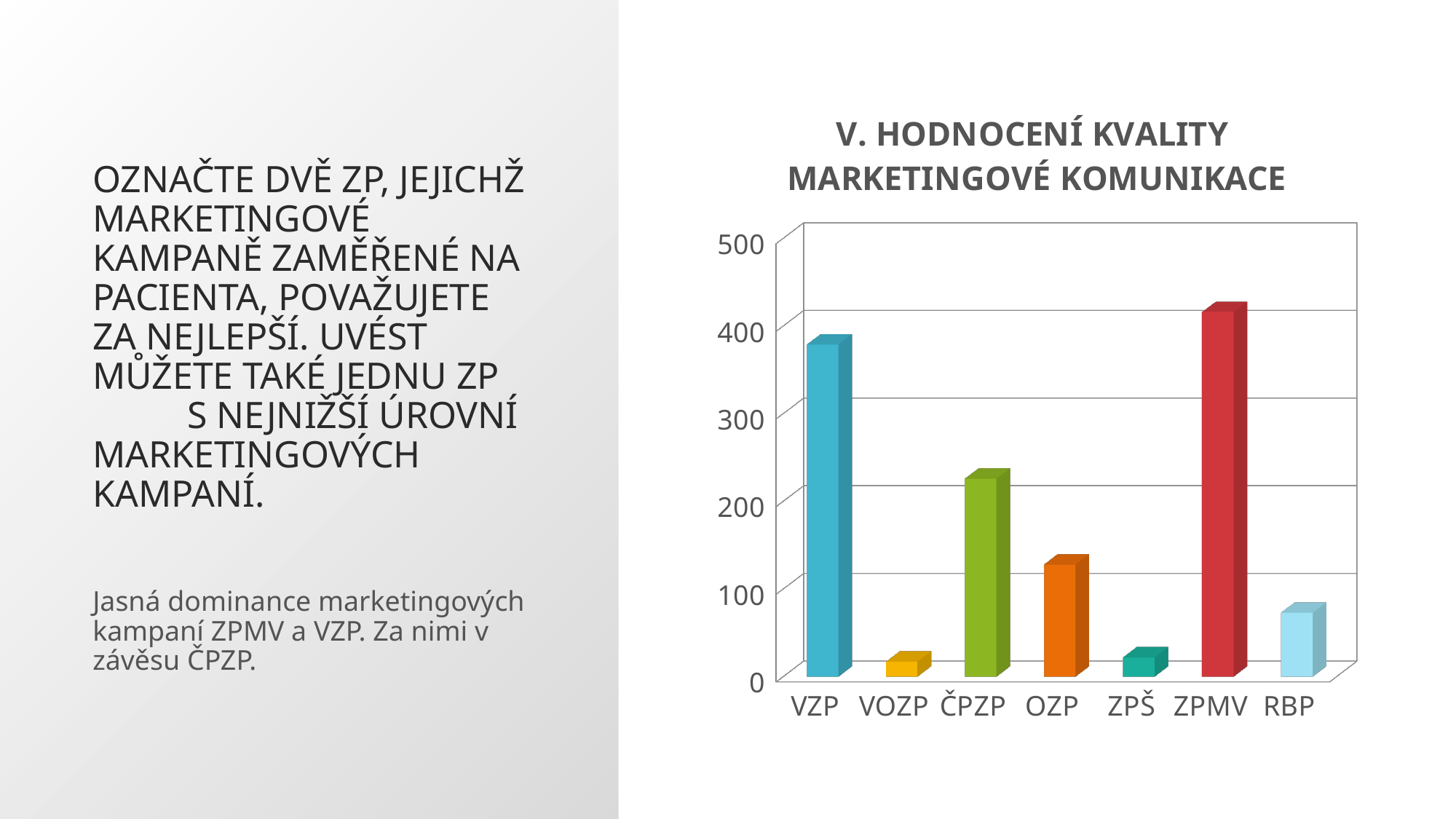
Which category has the highest bar in the chart? ZPMV Is the value for OZP greater or less than 100? greater What kind of chart is shown on the slide? bar chart Which is larger, the value for VZP or the value for ZPMV? ZPMV Which is larger, the value for ČPZP or the value for OZP? ČPZP Is the value for VZP greater or less than 300? greater What colour is the bar for ZPMV? red Is the value for RBP greater or less than 100? less How many categories are shown on the x axis of the chart? 7 What is the title of the chart? V. HODNOCENÍ KVALITY MARKETINGOVÉ KOMUNIKACE Which category has the lowest bar in the chart? VOZP